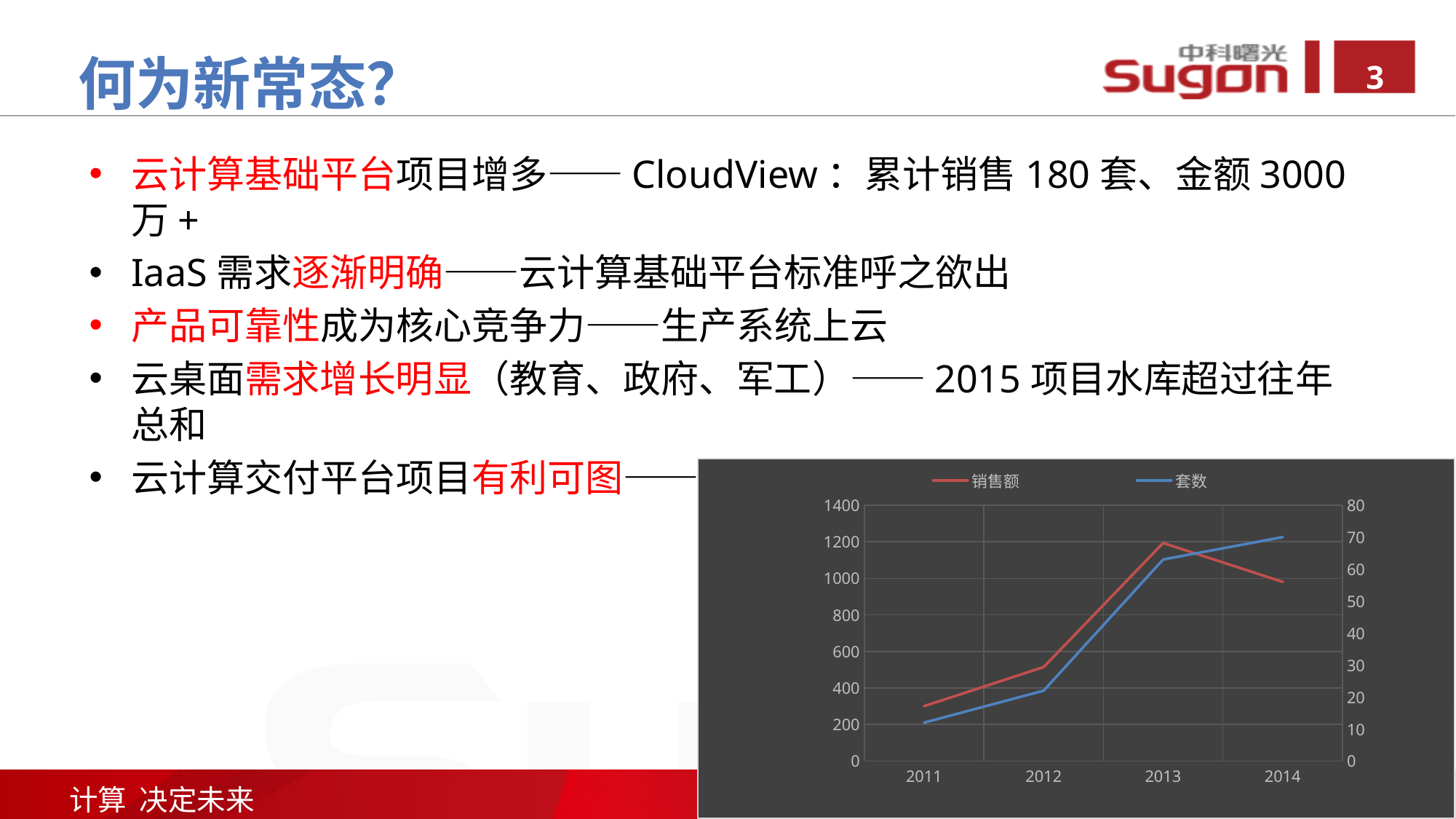
Is the 套数 value for 2014 greater or less than 60? greater What are the two series named in the chart legend? 销售额 and 套数 Does the 套数 line rise or fall from 2011 to 2014? rise Which year has the larger 销售额 value, 2013 or 2014? 2013 Is the 销售额 value for 2011 greater or less than 400? less Is the 销售额 value for 2013 greater or less than 1000? greater In which year does the 销售额 line reach its highest point? 2013 In which year is the 套数 line at its lowest? 2011 What kind of chart is shown on the slide? line chart How many years are plotted along the x axis of the chart? 4 How many series does the chart legend list? 2 In which year does the 套数 line reach its highest point? 2014